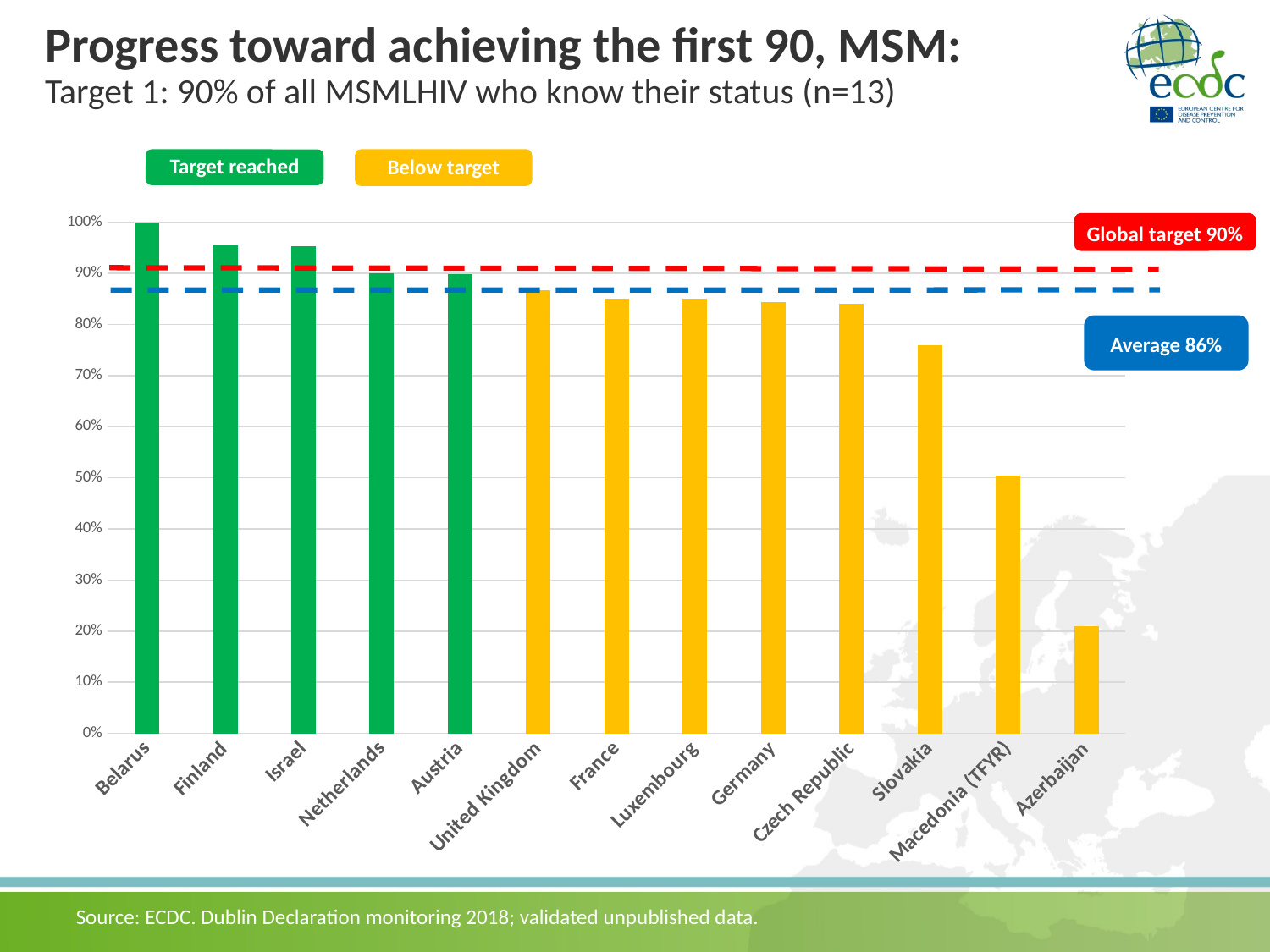
Is the value for Azerbaijan greater or less than 30%? less Is the value for Slovakia greater or less than 70%? greater Which country has the highest value in the chart? Belarus Is the value for Germany greater or less than 90%? less How many countries are plotted in the chart? 13 What kind of chart is shown on the slide? bar chart What average value is marked on the chart? 86% What is the value for Belarus? 100% What global target value is marked on the chart? 90% Do the values rise or fall moving from left to right along the x axis? fall Which country has the lowest value in the chart? Azerbaijan Which is larger, the value for Slovakia or the value for Macedonia (TFYR)? Slovakia